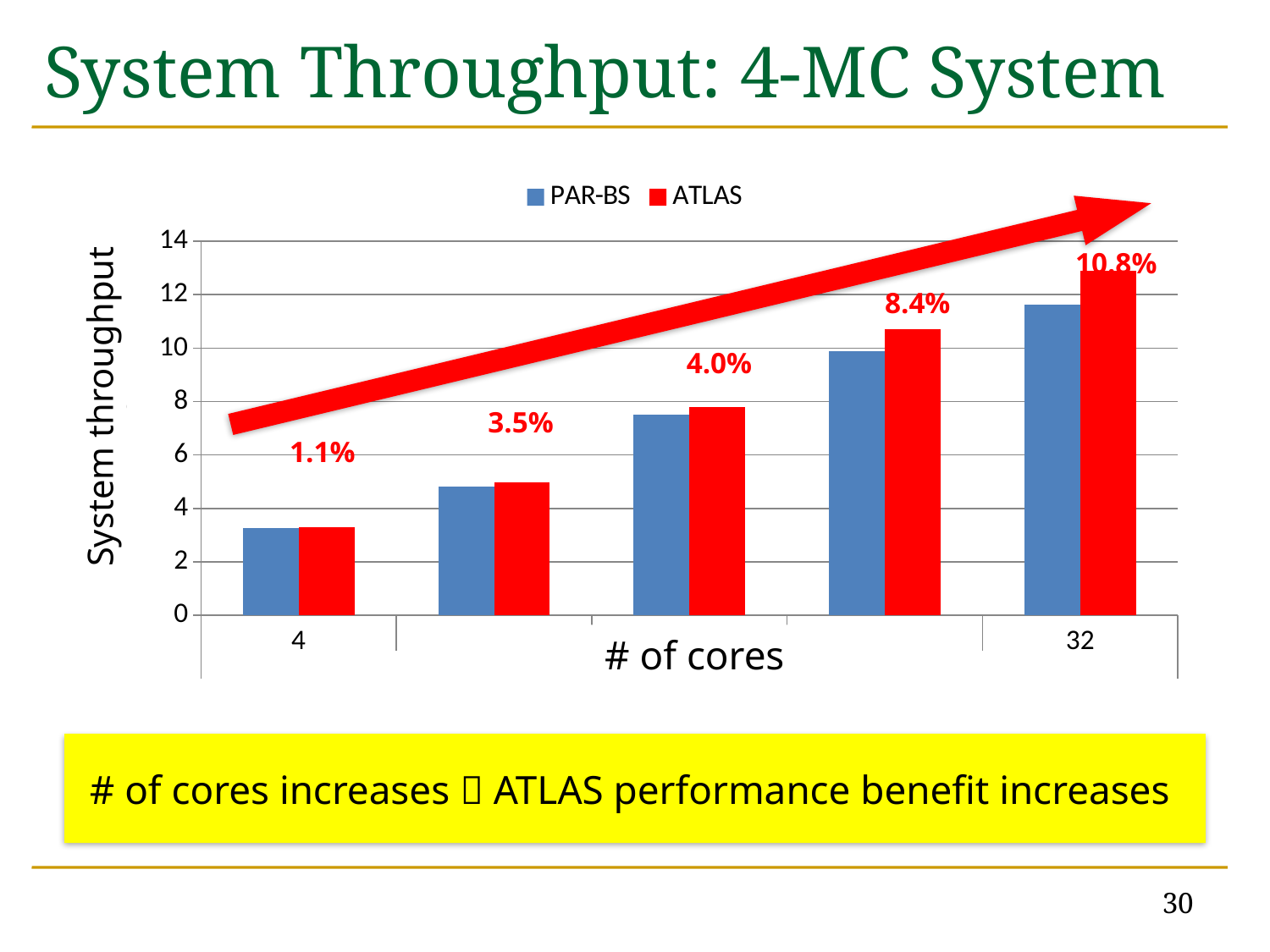
Is the PAR-BS system throughput at 4 cores greater or less than 4? less What kind of chart is shown on the slide? bar chart Is the ATLAS system throughput at 32 cores greater or less than 12? greater What percentage improvement is annotated above the bars for 32 cores? 10.8% How many groups of bars (core counts) are plotted on the chart? 5 What percentage is annotated above the middle (third) group of bars? 4.0% At 32 cores, which series has the higher system throughput, PAR-BS or ATLAS? ATLAS What percentage improvement is annotated above the bars for 4 cores? 1.1% How many series does the legend list? 2 Is the PAR-BS system throughput at 32 cores greater or less than 10? greater What are the two series named in the legend? PAR-BS and ATLAS Does system throughput rise or fall as the number of cores increases along the x axis? rise